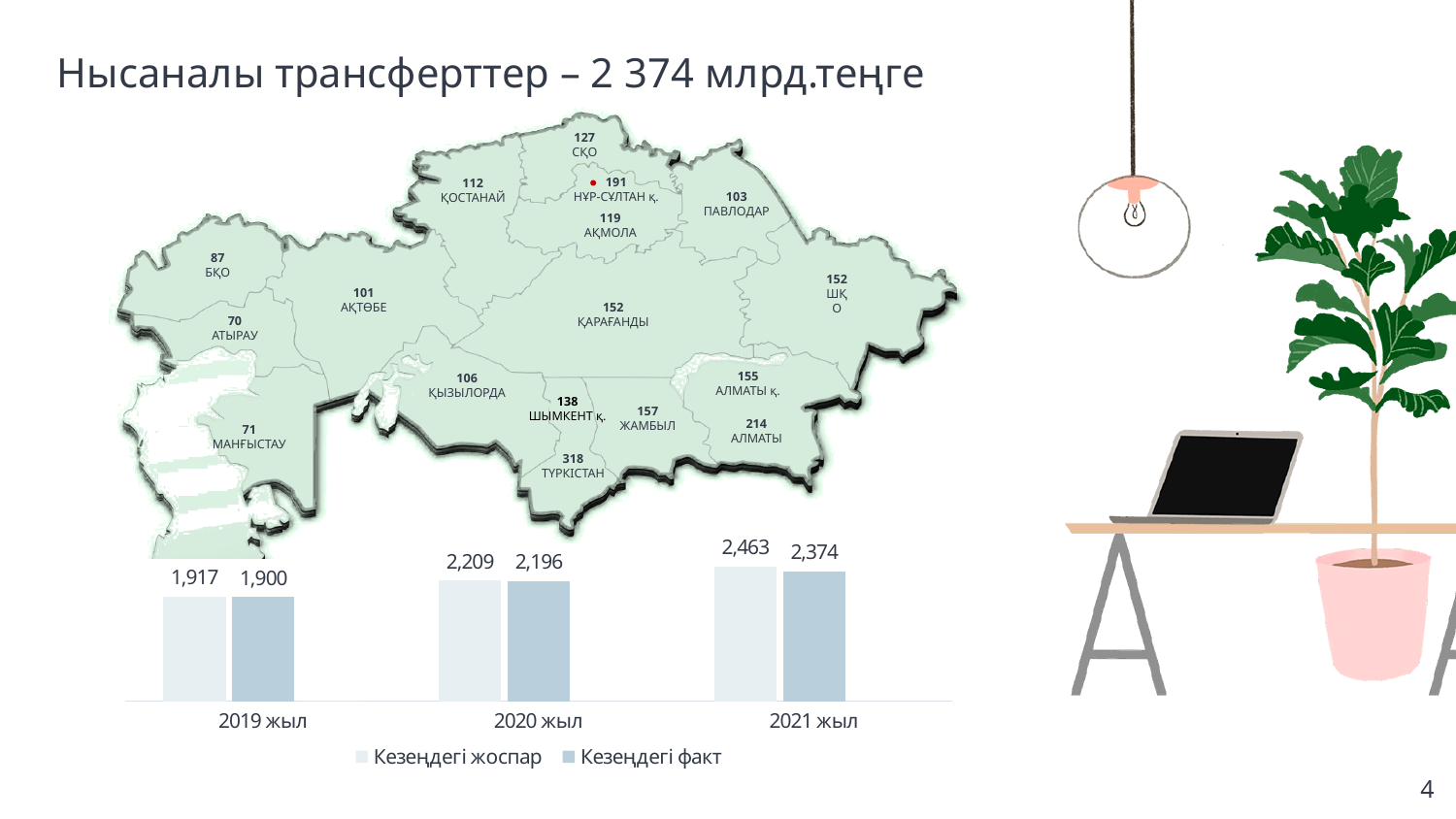
Does the value of Кезеңдегі факт rise or fall from 2019 жыл to 2021 жыл? rise What is the value of Кезеңдегі жоспар for 2019 жыл? 1,917 What kind of chart is shown at the bottom of the slide? bar chart What is the value of Кезеңдегі жоспар for 2021 жыл? 2,463 What is the value of Кезеңдегі факт for 2021 жыл? 2,374 What are the two legend entries of the bar chart? Кезеңдегі жоспар, Кезеңдегі факт How many year categories are shown on the x axis of the bar chart? 3 What is the value of Кезеңдегі факт for 2020 жыл? 2,196 Which year has the lowest value for Кезеңдегі факт? 2019 жыл Which year has the highest value for Кезеңдегі жоспар? 2021 жыл How many series does the legend of the bar chart list? 2 What is the difference between Кезеңдегі жоспар and Кезеңдегі факт for 2021 жыл? 89